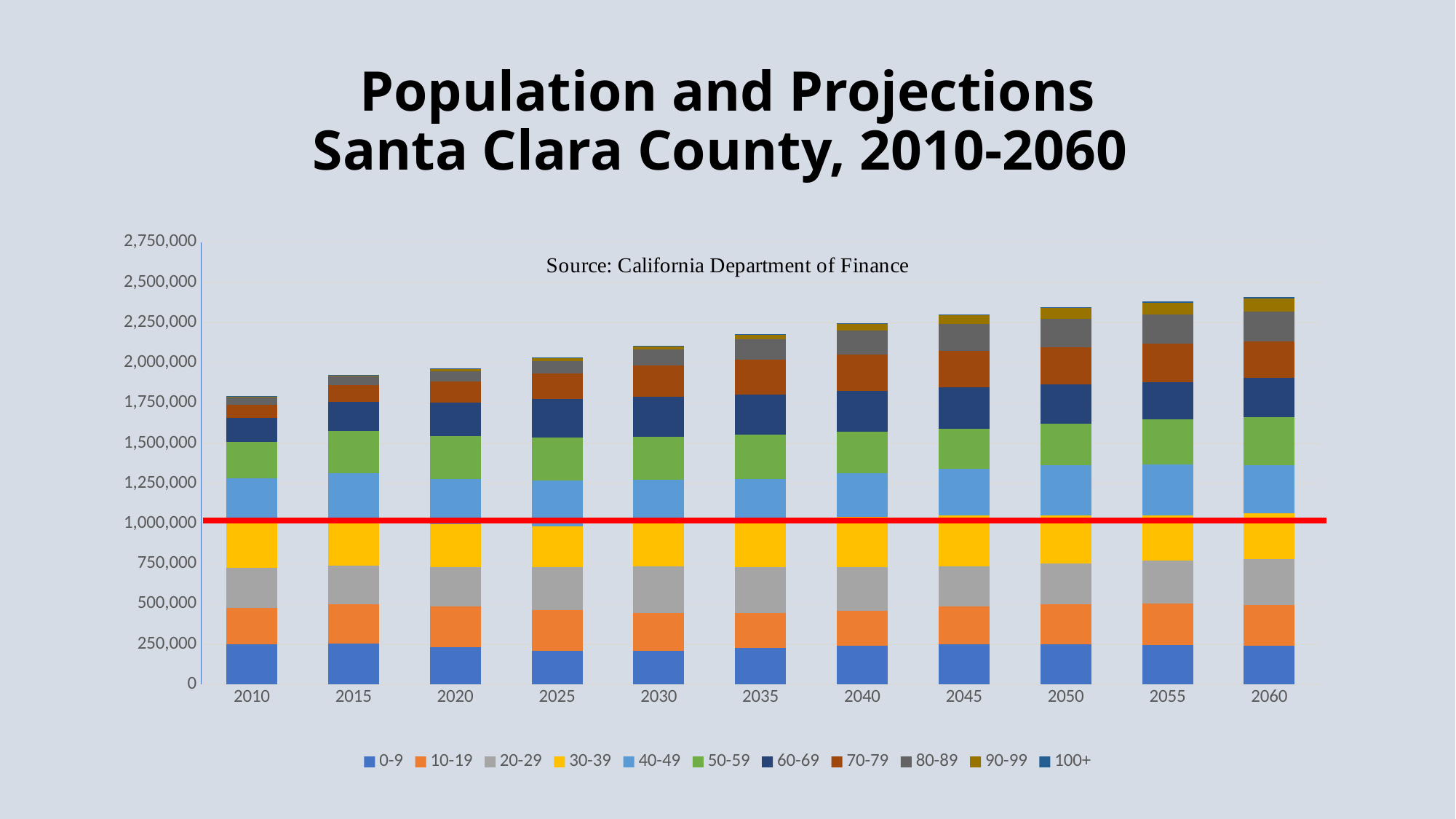
At what value on the y axis is the horizontal red line drawn? 1,000,000 Which year has the lowest total population bar? 2010 Is the total population bar for 2060 greater or less than 2,250,000? greater Which total population bar is taller, 2010 or 2060? 2060 Which year has the highest total population bar? 2060 What kind of chart is shown on the slide? stacked bar chart What source is cited on the chart? California Department of Finance How many years are shown along the x axis of the chart? 11 Do the total population bars rise or fall from 2010 to 2060? rise Is the total population bar for 2030 greater or less than 2,000,000? greater How many age-group series does the legend list? 11 Is the total population bar for 2010 greater or less than 2,000,000? less